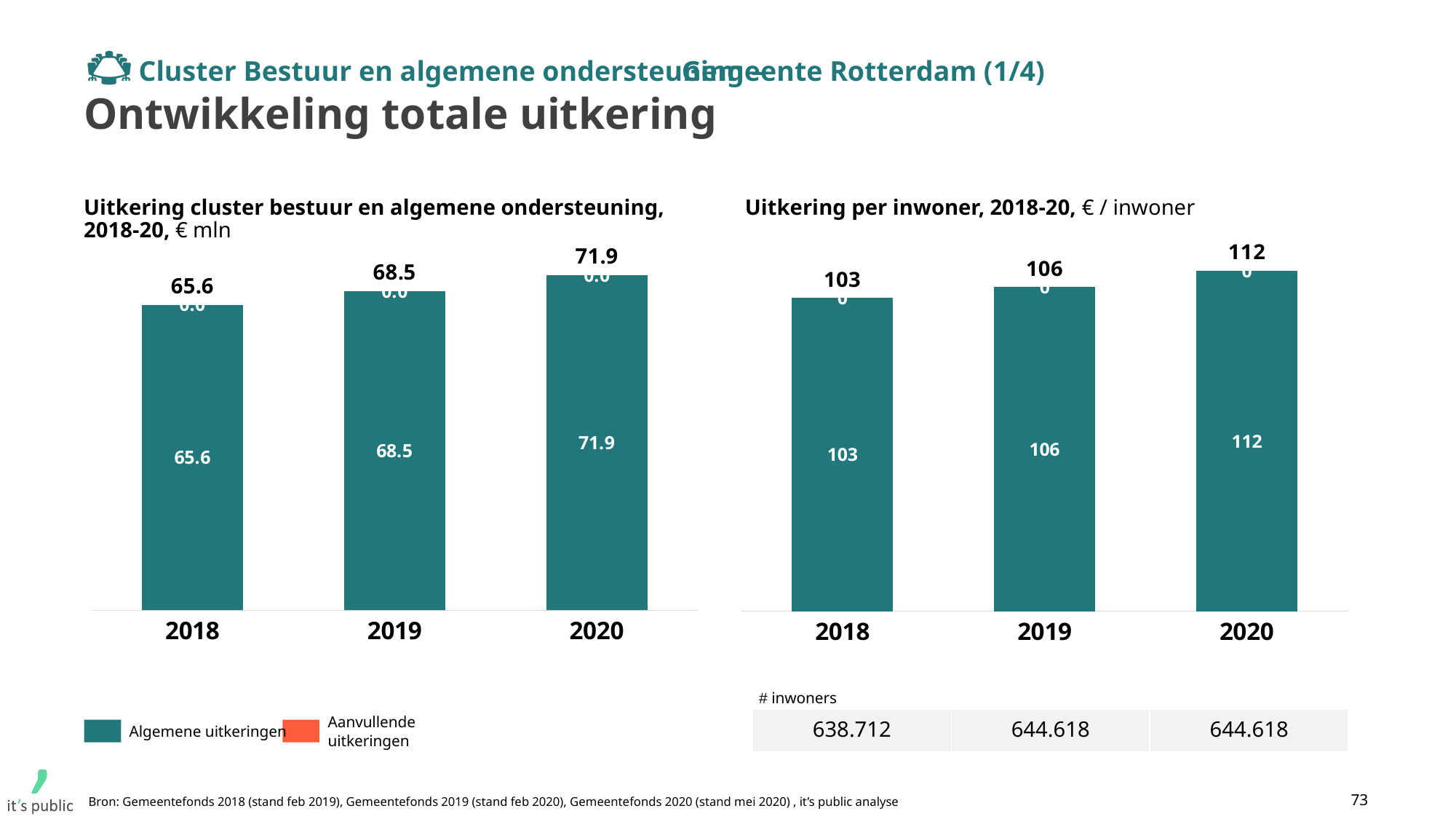
In the right chart (Uitkering per inwoner), which year has the highest value? 2020 In the left chart (Uitkering cluster bestuur en algemene ondersteuning), what is the difference between the 2020 and 2018 totals? 6.3 How many years are shown on the x axis of the left chart (Uitkering cluster bestuur en algemene ondersteuning)? 3 In the left chart (Uitkering cluster bestuur en algemene ondersteuning), which year has the lowest total? 2018 What kind of chart is the right chart (Uitkering per inwoner)? bar chart In the right chart (Uitkering per inwoner), what is the value for 2019? 106 In the left chart (Uitkering cluster bestuur en algemene ondersteuning), do the totals rise or fall from 2018 to 2020? rise How many series does the legend of the left chart (Uitkering cluster bestuur en algemene ondersteuning) list? 2 In the left chart (Uitkering cluster bestuur en algemene ondersteuning), what is the total value for 2020? 71.9 In the right chart (Uitkering per inwoner), is the value for 2019 larger or smaller than the value for 2020? smaller In the left chart (Uitkering cluster bestuur en algemene ondersteuning), what is the total value for 2018? 65.6 In the right chart (Uitkering per inwoner), what is the difference between the 2020 and 2018 values? 9